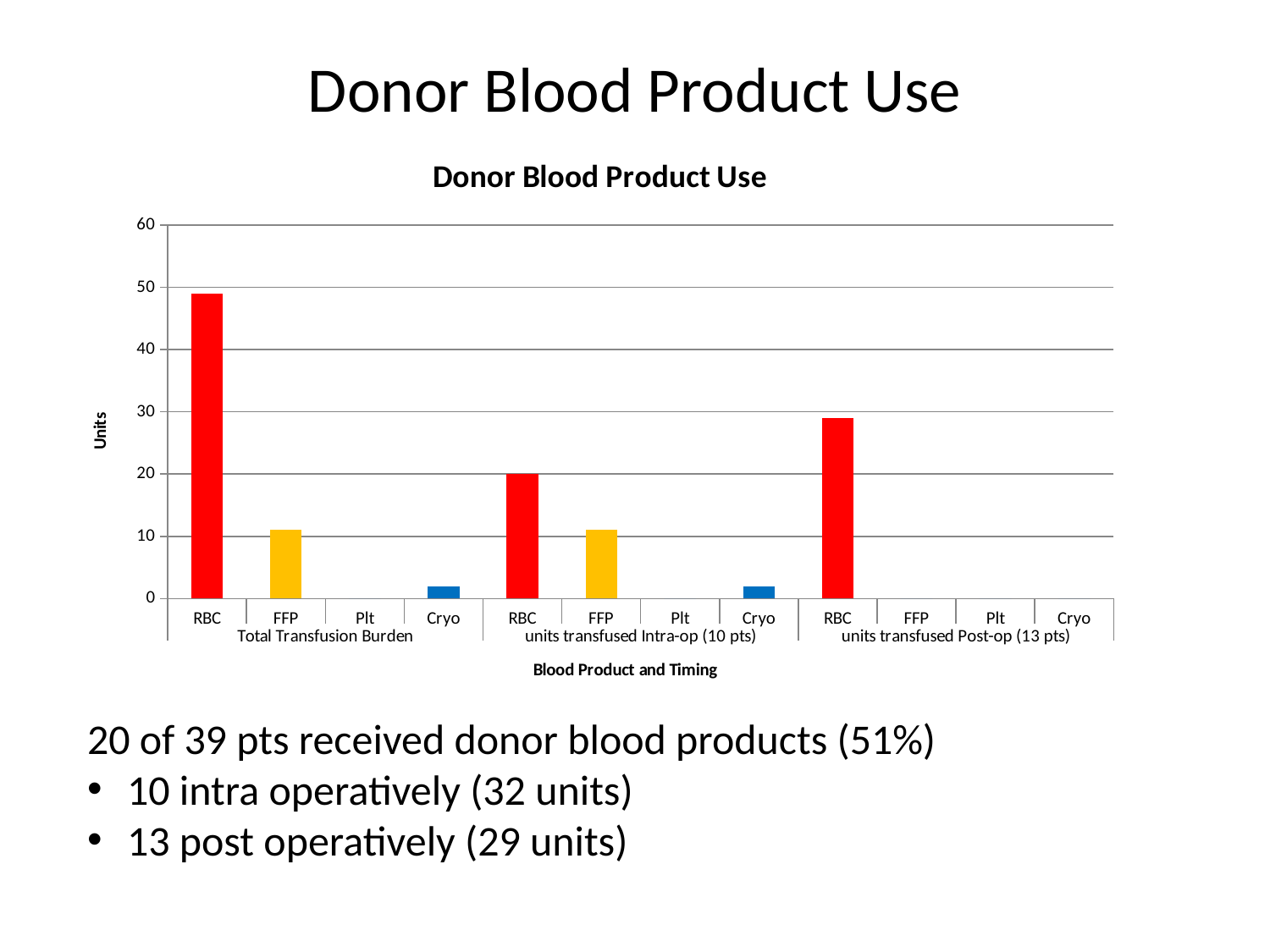
Which is larger: RBC under Total Transfusion Burden or RBC under units transfused Post-op (13 pts)? RBC under Total Transfusion Burden Which category has the highest value in the chart? RBC (Total Transfusion Burden) What kind of chart is shown on the slide? bar chart Is the value for RBC under Total Transfusion Burden greater or less than 40? greater Is the value for Cryo under Total Transfusion Burden greater or less than 10? less How many bars (categories) are shown along the x axis of the chart? 12 What is the label on the vertical axis of the chart? Units Is the value for RBC under units transfused Post-op (13 pts) greater or less than 20? greater What is the title of the chart? Donor Blood Product Use How many units of RBC were transfused Intra-op (10 pts)? 20 Which is larger: RBC under units transfused Intra-op (10 pts) or FFP under units transfused Intra-op (10 pts)? RBC